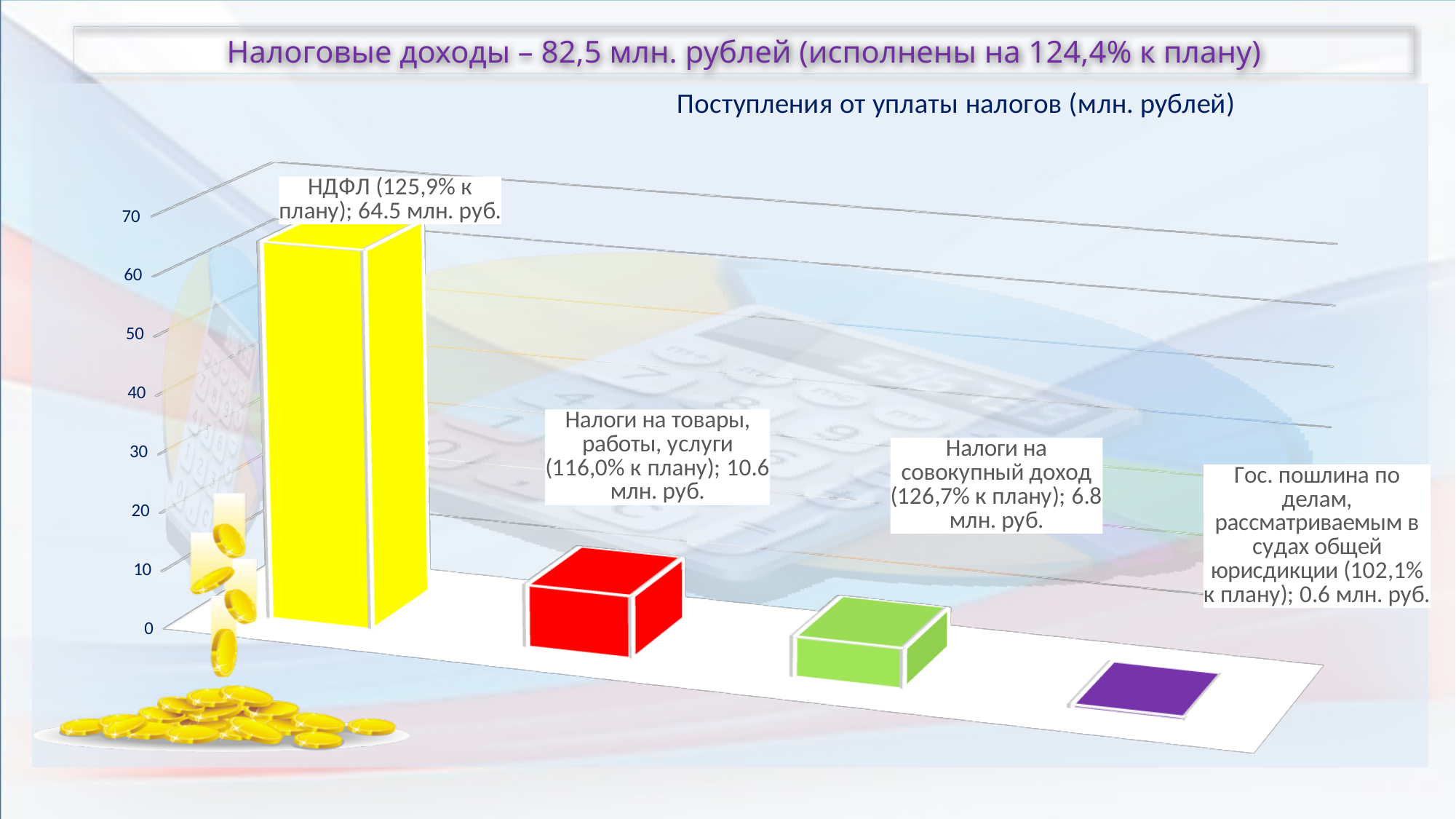
Which is larger: Налоги на товары, работы, услуги or Налоги на совокупный доход? Налоги на товары, работы, услуги What is the value for НДФЛ? 64.5 млн. руб. How many bars (categories) does the chart show? 4 What is the value for Гос. пошлина по делам, рассматриваемым в судах общей юрисдикции? 0.6 млн. руб. What is the title of the chart? Поступления от уплаты налогов (млн. рублей) What is the value for Налоги на совокупный доход? 6.8 млн. руб. What is the difference between the values for НДФЛ and Налоги на товары, работы, услуги? 53.9 млн. руб. Which category has the lowest value? Гос. пошлина по делам, рассматриваемым в судах общей юрисдикции What percentage of the plan was achieved for НДФЛ, according to its data label? 125,9% What type of chart is shown on the slide? Bar chart Which category has the highest value? НДФЛ What is the value for Налоги на товары, работы, услуги? 10.6 млн. руб.